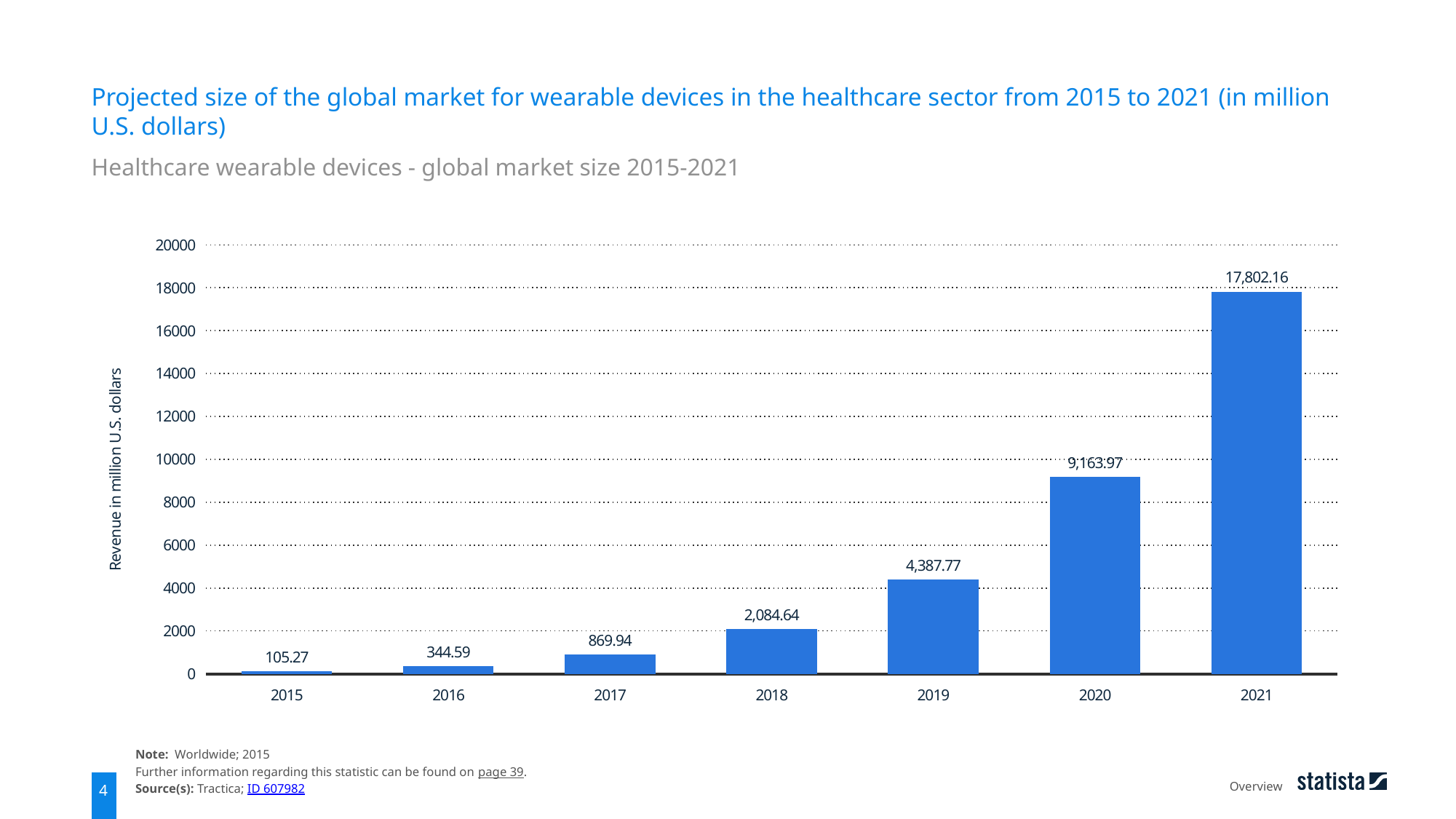
What is the difference between the values for 2021 and 2020? 8,638.19 Is the value for 2020 greater or less than 8000? greater Which year has the lowest projected market size? 2015 How many years are shown on the x axis? 7 What is the difference between the values for 2017 and 2016? 525.35 What is the value shown for 2015? 105.27 What is the projected market size for wearable devices in healthcare in 2021? 17,802.16 Which year has the highest projected market size? 2021 What is the projected market size for wearable devices in healthcare in 2018? 2,084.64 Do the values rise or fall from 2015 to 2021? Rise What kind of chart is shown on the slide? Bar chart Which is larger, the value for 2019 or the value for 2018? 2019